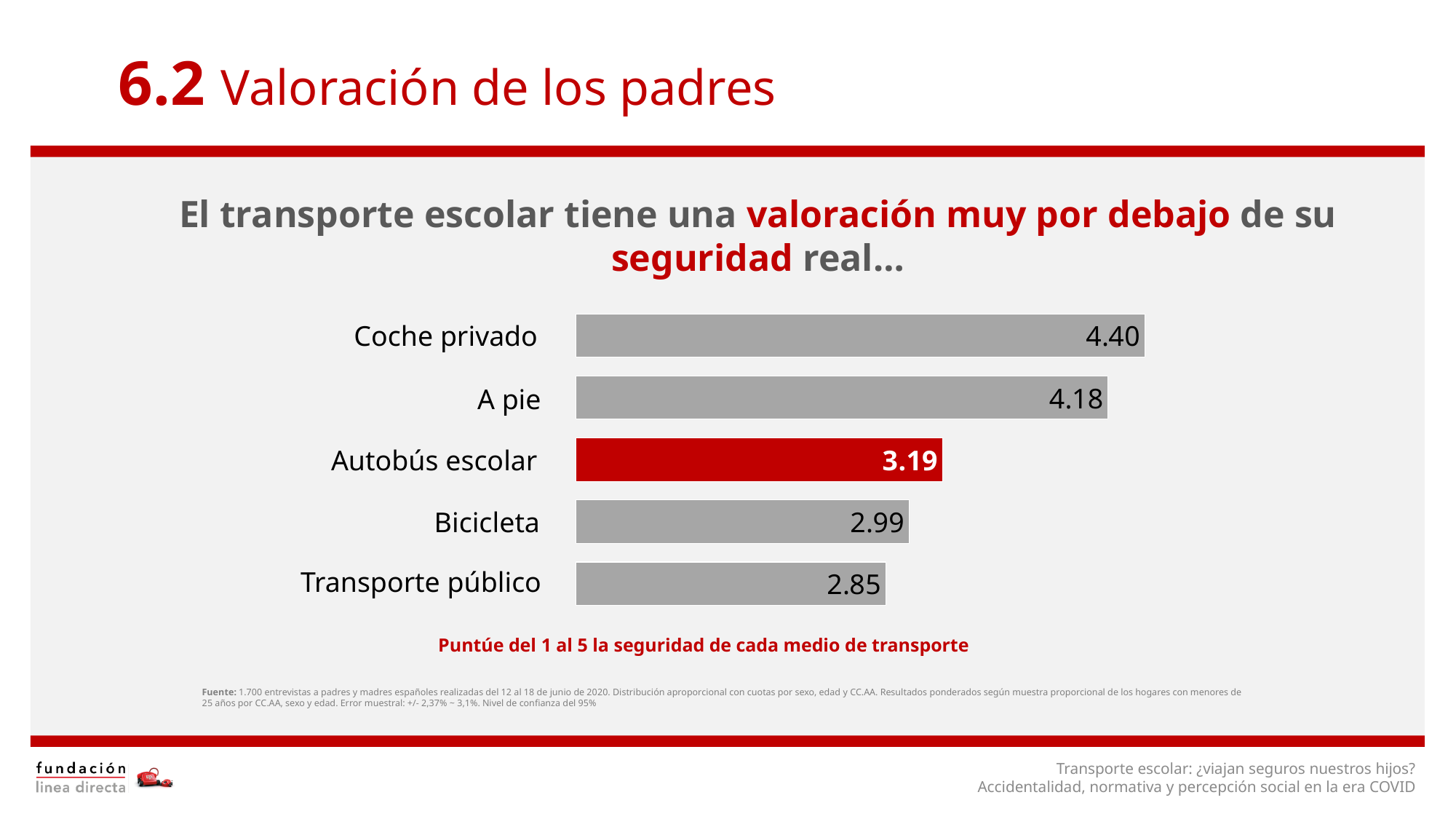
What is the value for Autobús escolar? 3.19 What is the value for Coche privado? 4.40 What is the difference between the values for Coche privado and Autobús escolar? 1.21 Which category has the lowest value? Transporte público What kind of chart is shown on the slide? Bar chart What is the value for Bicicleta? 2.99 Which bar is highlighted in red? Autobús escolar Which is larger, the value for A pie or the value for Bicicleta? A pie How many categories are shown in the chart? 5 Which category has the highest value? Coche privado What is the difference between the values for A pie and Transporte público? 1.33 What is the value for Transporte público? 2.85